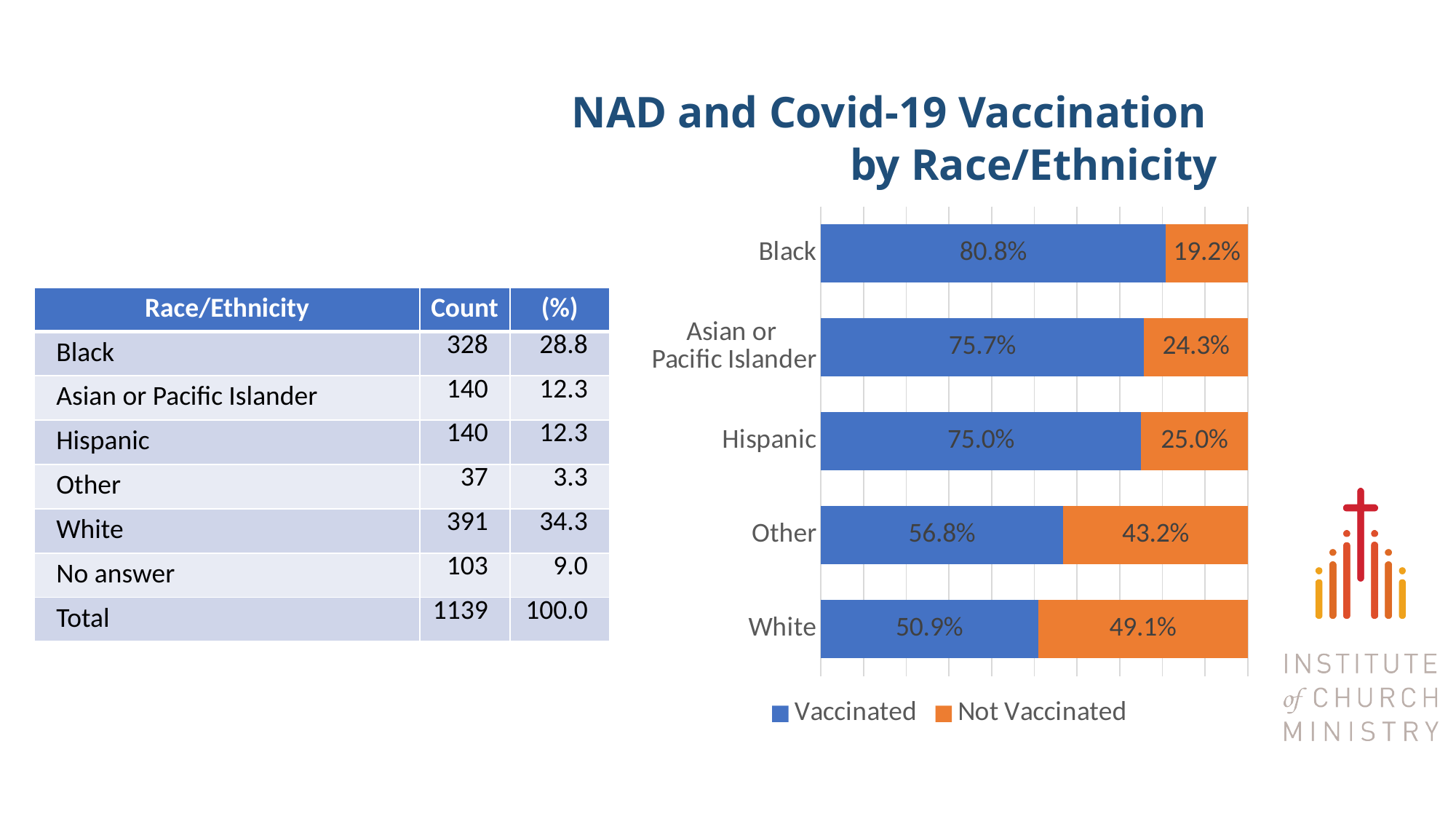
What colour represents the Not Vaccinated series in the chart? Orange How many race/ethnicity categories are shown in the chart? 5 What is the Vaccinated percentage for Black? 80.8% Which race/ethnicity category has the lowest Vaccinated percentage? White Which race/ethnicity category has the highest Vaccinated percentage? Black What is the total of the stacked bar for Hispanic? 100.0% Which is larger, the Not Vaccinated percentage for Other or for Hispanic? Other What kind of chart is shown on the slide? Stacked bar chart What is the Not Vaccinated percentage for White? 49.1% What is the Not Vaccinated percentage for Asian or Pacific Islander? 24.3% What is the difference between the Vaccinated percentages for Black and White? 29.9% How many series does the legend list? 2